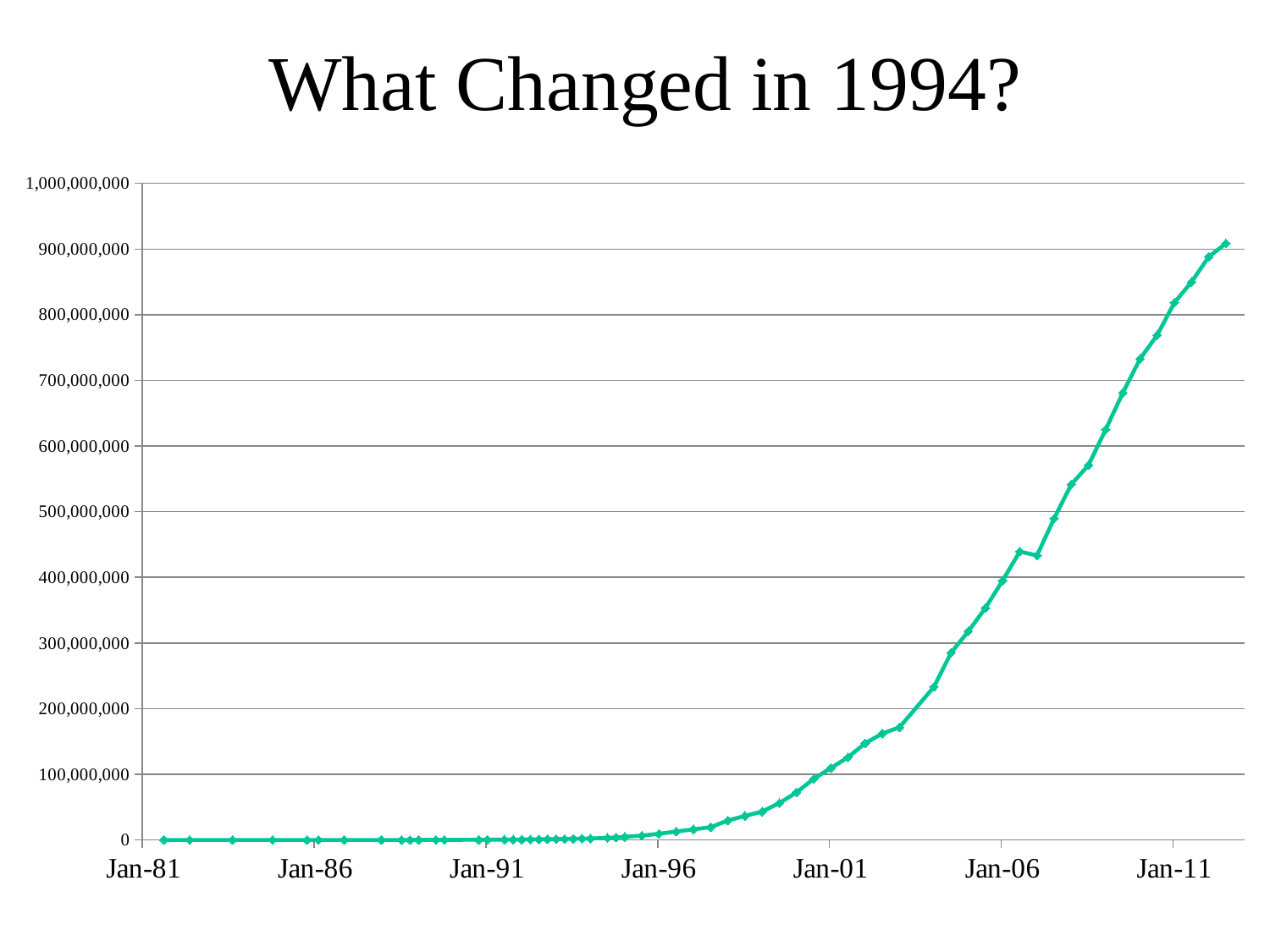
Which is larger, the value at Jan-01 or the value at Jan-06? Jan-06 Is the value at Jan-96 greater or less than 100,000,000? less What is the title of the slide containing the chart? What Changed in 1994? Is the value at Jan-06 greater or less than 300,000,000? greater Is the value at Jan-91 greater or less than 100,000,000? less How many labelled tick marks are shown on the horizontal axis? 7 Which is larger, the value at Jan-86 or the value at Jan-11? Jan-11 Do the plotted values generally rise or fall from Jan-81 to the end of the series? rise What kind of chart is shown on the slide? line chart What is the maximum value shown on the vertical axis? 1,000,000,000